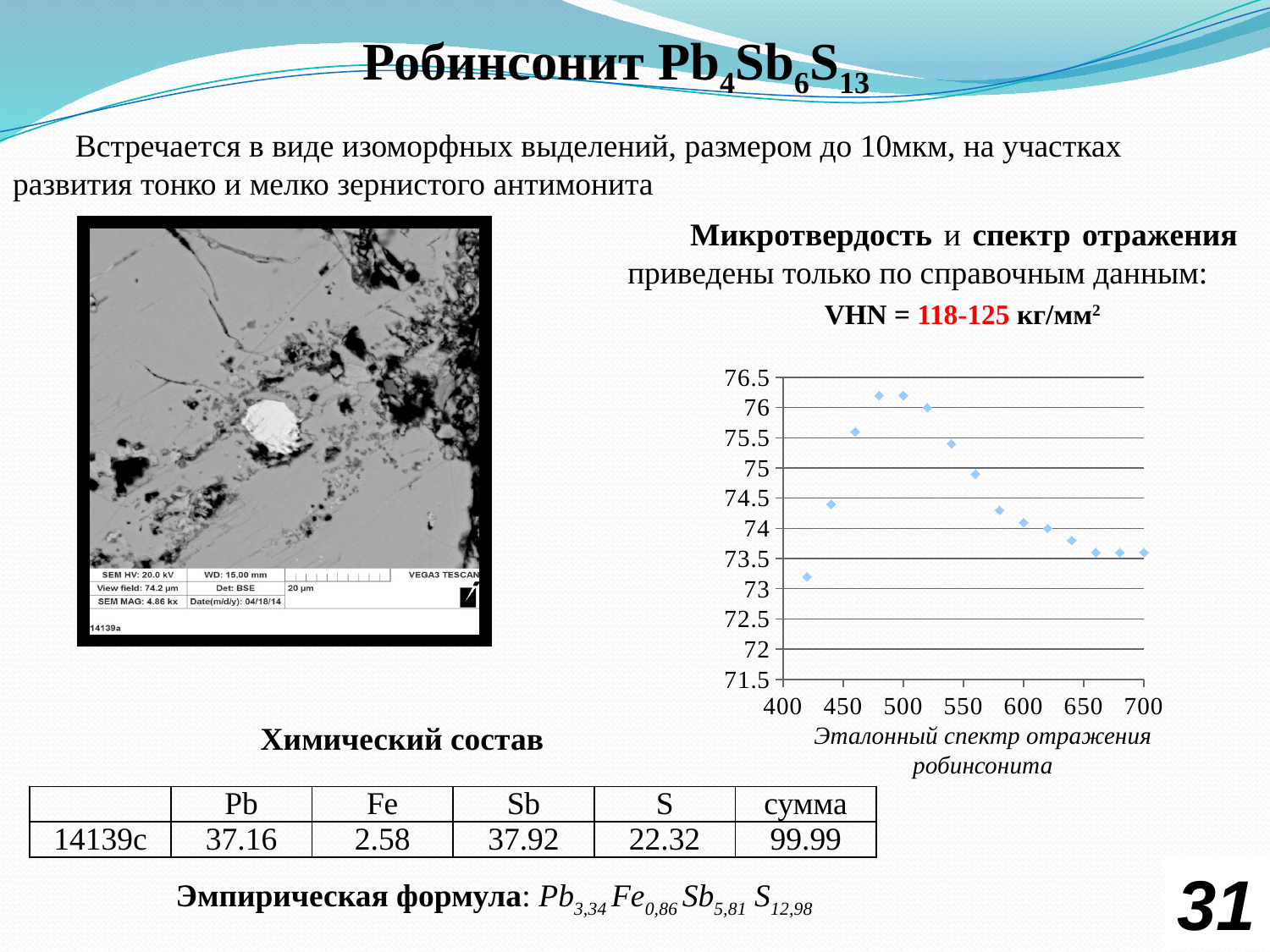
How many data points are plotted on the chart? 15 Is the value at x = 500 larger or smaller than the value at x = 700? larger Do the values rise or fall along the x axis from 500 to 700? fall Do the values rise or fall along the x axis from 400 to 500? rise Is the value at x = 500 greater or less than 75? greater Is the value at x = 600 greater or less than 74.5? less What is the lowest value shown on the y axis of the chart? 71.5 Is the value at x = 500 greater or less than 76? greater What is the caption printed under the chart? Эталонный спектр отражения робинсонита What kind of chart is shown on the slide? scatter chart